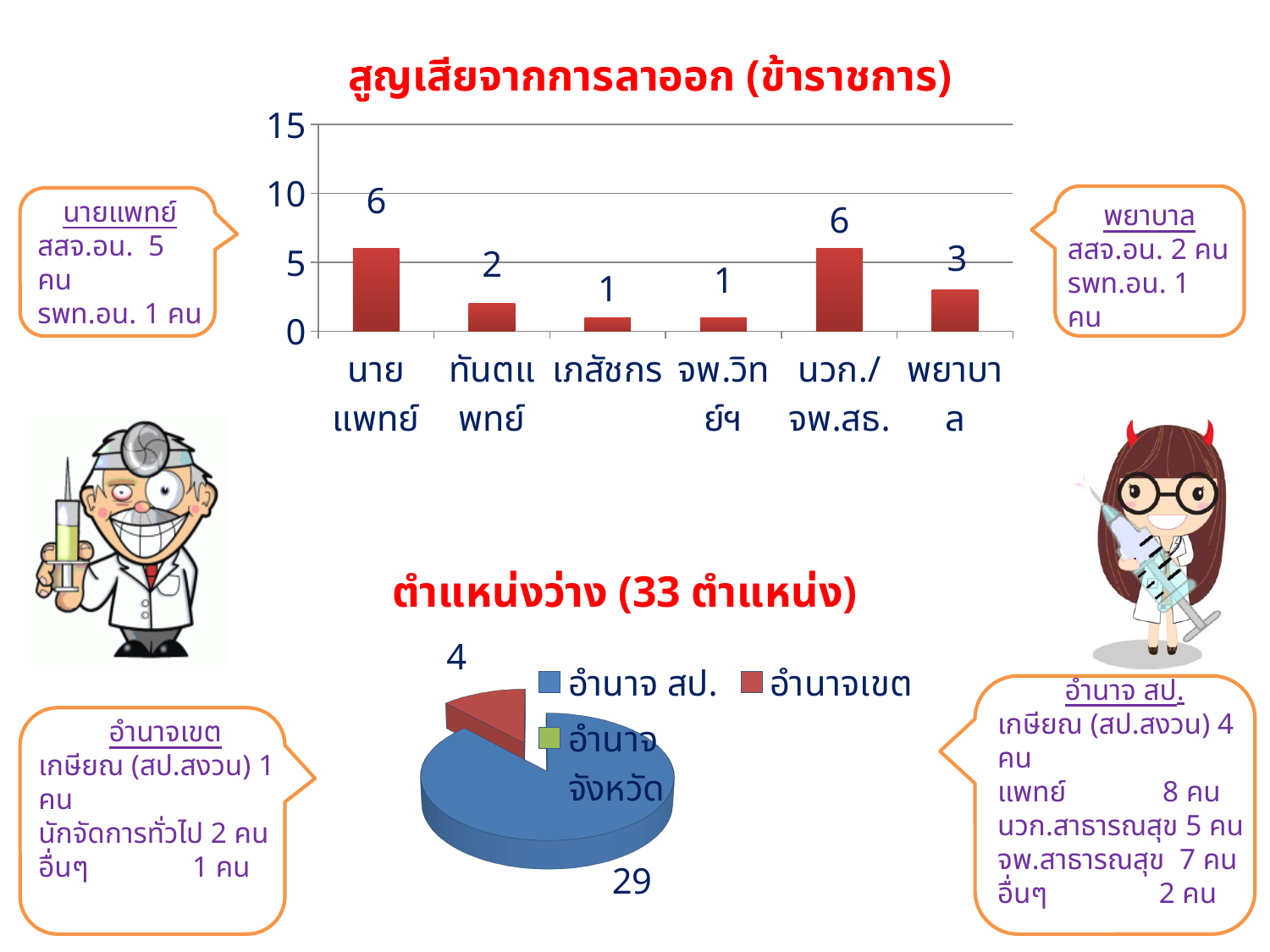
In the bar chart titled สูญเสียจากการลาออก (ข้าราชการ), how many categories are shown on the x axis? 6 In the bar chart titled สูญเสียจากการลาออก (ข้าราชการ), is the value for นวก./จพ.สธ. greater or less than 5? greater In the pie chart titled ตำแหน่งว่าง (33 ตำแหน่ง), what is the value of the อำนาจ สป. slice? 29 In the pie chart titled ตำแหน่งว่าง (33 ตำแหน่ง), how many entries does the legend list? 3 In the bar chart titled สูญเสียจากการลาออก (ข้าราชการ), what is the value for เภสัชกร? 1 What type of chart is the top chart titled สูญเสียจากการลาออก (ข้าราชการ)? bar chart In the bar chart titled สูญเสียจากการลาออก (ข้าราชการ), which category has the lowest value, ทันตแพทย์ or พยาบาล? ทันตแพทย์ What type of chart is the bottom chart titled ตำแหน่งว่าง (33 ตำแหน่ง)? pie chart In the bar chart titled สูญเสียจากการลาออก (ข้าราชการ), what is the difference between the values for นายแพทย์ and พยาบาล? 3 In the bar chart titled สูญเสียจากการลาออก (ข้าราชการ), what is the value for ทันตแพทย์? 2 In the bar chart titled สูญเสียจากการลาออก (ข้าราชการ), what is the value for พยาบาล? 3 In the pie chart titled ตำแหน่งว่าง (33 ตำแหน่ง), what is the value of the อำนาจเขต slice? 4